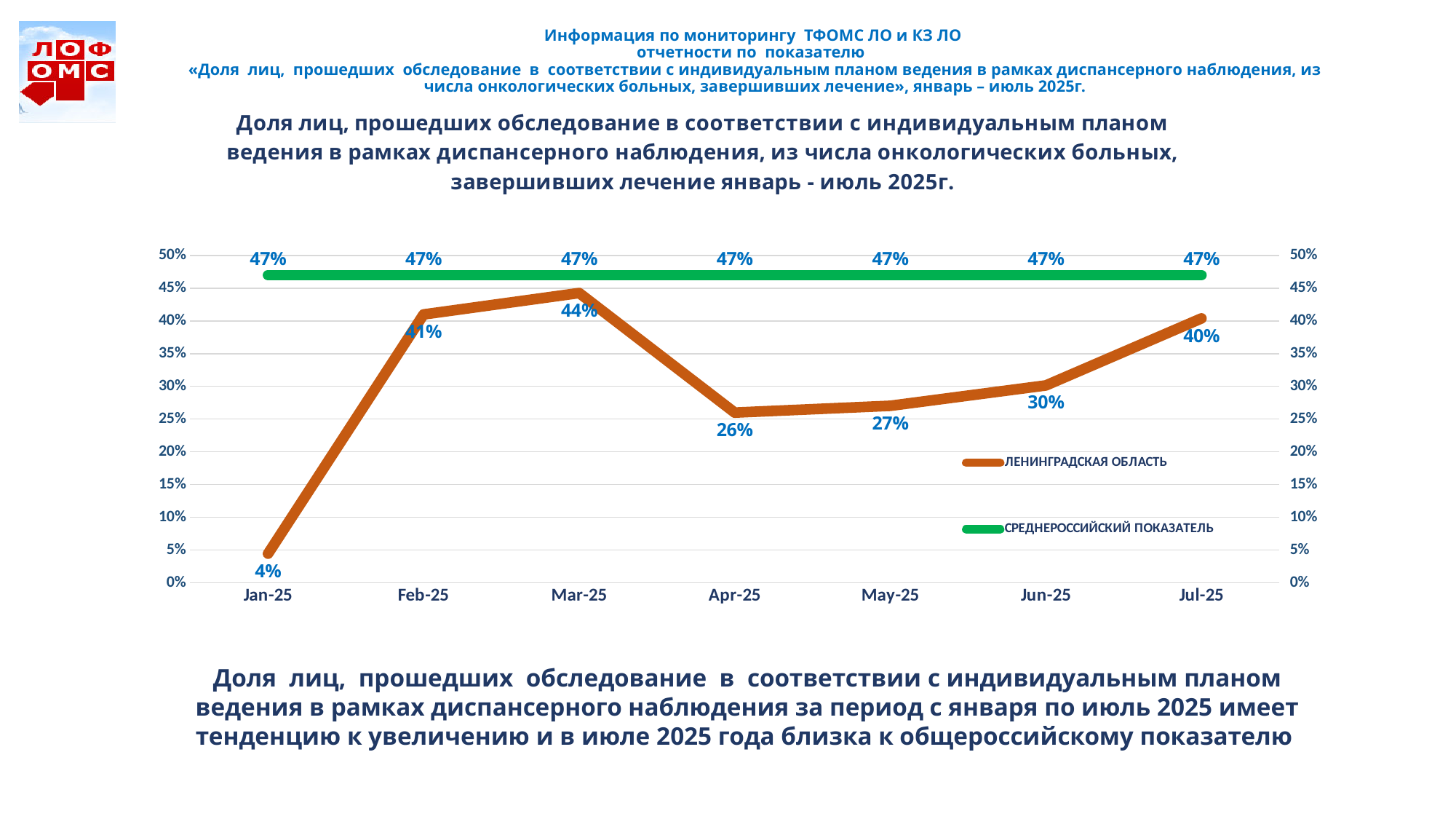
In which month is the value for ЛЕНИНГРАДСКАЯ ОБЛАСТЬ the highest? Mar-25 In which month is the value for ЛЕНИНГРАДСКАЯ ОБЛАСТЬ the lowest? Jan-25 What is the value of СРЕДНЕРОССИЙСКИЙ ПОКАЗАТЕЛЬ in May-25? 47% Which is larger for ЛЕНИНГРАДСКАЯ ОБЛАСТЬ: the value in Feb-25 or the value in Apr-25? Feb-25 How many series does the legend list? 2 What is the value for ЛЕНИНГРАДСКАЯ ОБЛАСТЬ in Jul-25? 40% What kind of chart is shown on the slide? Line chart What is the value for ЛЕНИНГРАДСКАЯ ОБЛАСТЬ in Jan-25? 4% What is the value for ЛЕНИНГРАДСКАЯ ОБЛАСТЬ in Mar-25? 44% How many months are plotted on the x axis? 7 What is the difference between the СРЕДНЕРОССИЙСКИЙ ПОКАЗАТЕЛЬ and the ЛЕНИНГРАДСКАЯ ОБЛАСТЬ value in Jul-25? 7% Does the ЛЕНИНГРАДСКАЯ ОБЛАСТЬ line rise or fall from Apr-25 to Jul-25? Rise